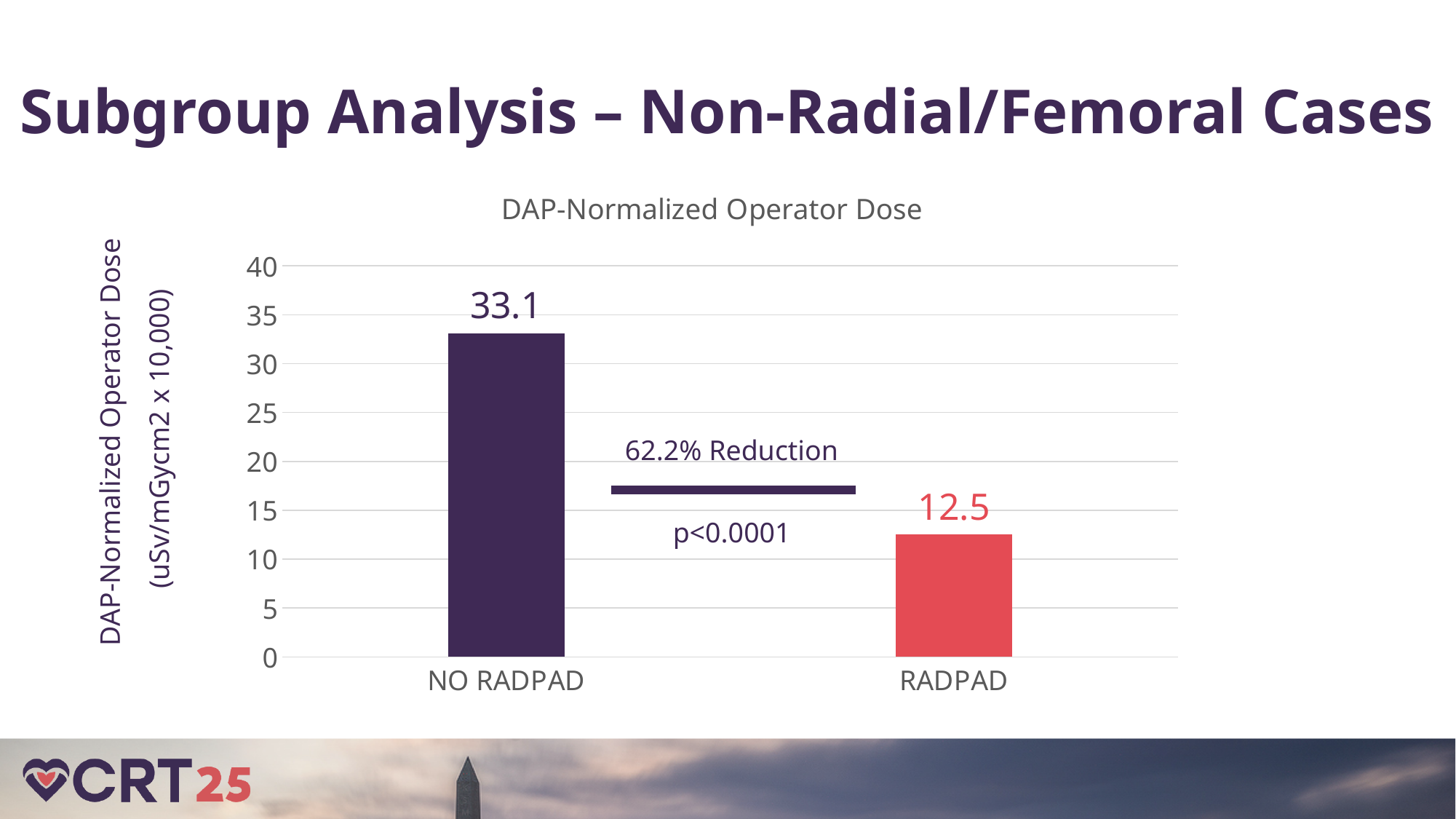
How many categories are shown on the x axis? 2 What is the DAP-normalized operator dose for RADPAD? 12.5 Which is larger, the value for NO RADPAD or the value for RADPAD? NO RADPAD What percentage reduction is annotated between the two bars? 62.2% Reduction What kind of chart is shown on the slide? bar chart Which category has the highest DAP-normalized operator dose? NO RADPAD What is the difference between the NO RADPAD and RADPAD values? 20.6 Which category has the lowest DAP-normalized operator dose? RADPAD Is the value for RADPAD greater or less than 15? less What is the title of the chart? DAP-Normalized Operator Dose What is the DAP-normalized operator dose for NO RADPAD? 33.1 Is the value for NO RADPAD greater or less than 30? greater